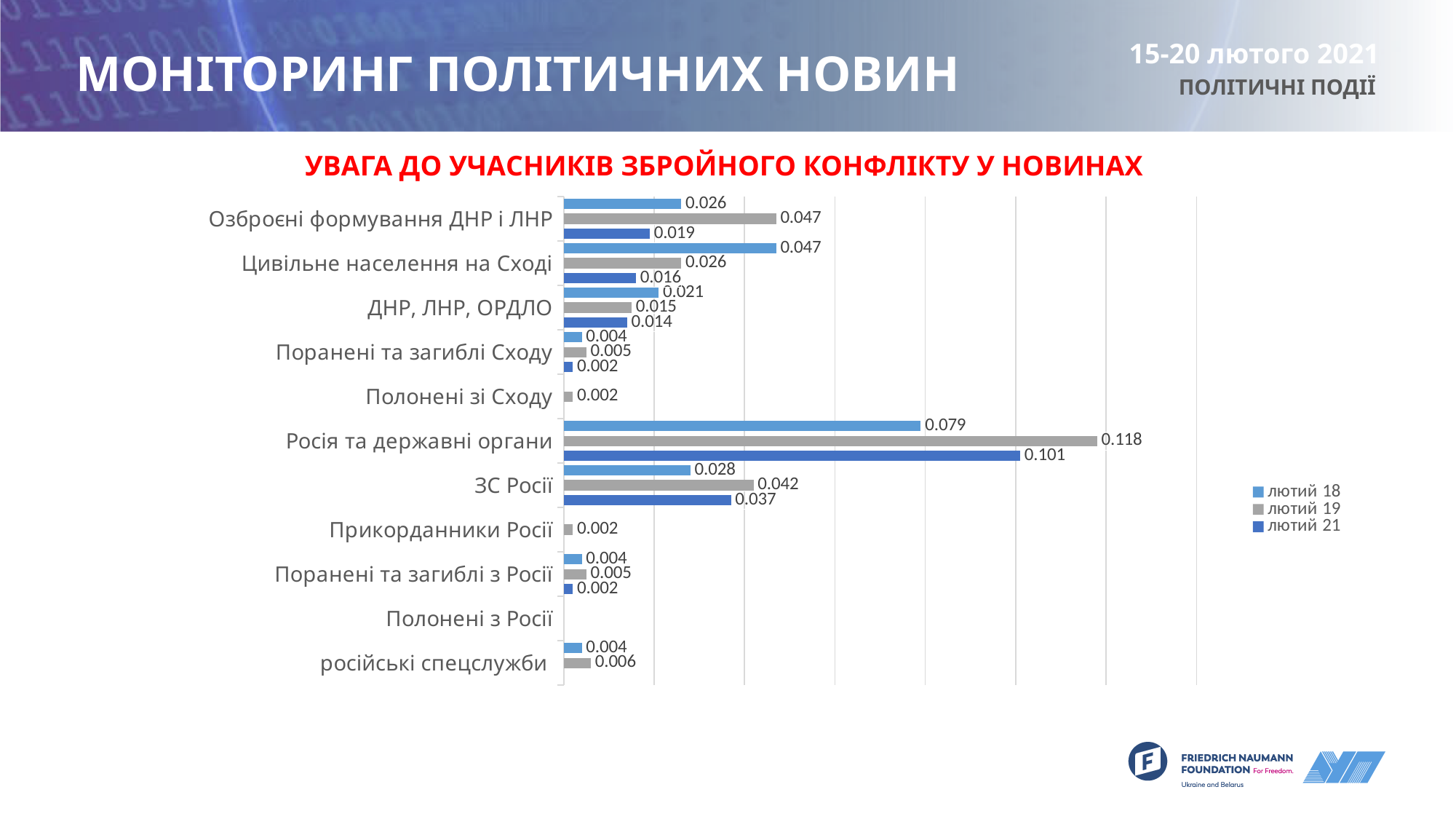
How many categories are listed on the vertical axis of the chart? 11 What is the difference between the лютий 19 and лютий 21 values for Росія та державні органи? 0.017 Which is larger for Озброєні формування ДНР і ЛНР: the лютий 18 value or the лютий 19 value? лютий 19 How many series does the legend list? 3 What is the value for ЗС Росії in the лютий 21 series? 0.037 What is the value for Цивільне населення на Сході in the лютий 18 series? 0.047 Which colour represents the лютий 19 series in the legend? Grey Which category has the highest value in the лютий 21 series? Росія та державні органи What kind of chart is shown on the slide? Bar chart What is the title of the chart? УВАГА ДО УЧАСНИКІВ ЗБРОЙНОГО КОНФЛІКТУ У НОВИНАХ What is the value for Росія та державні органи in the лютий 19 series? 0.118